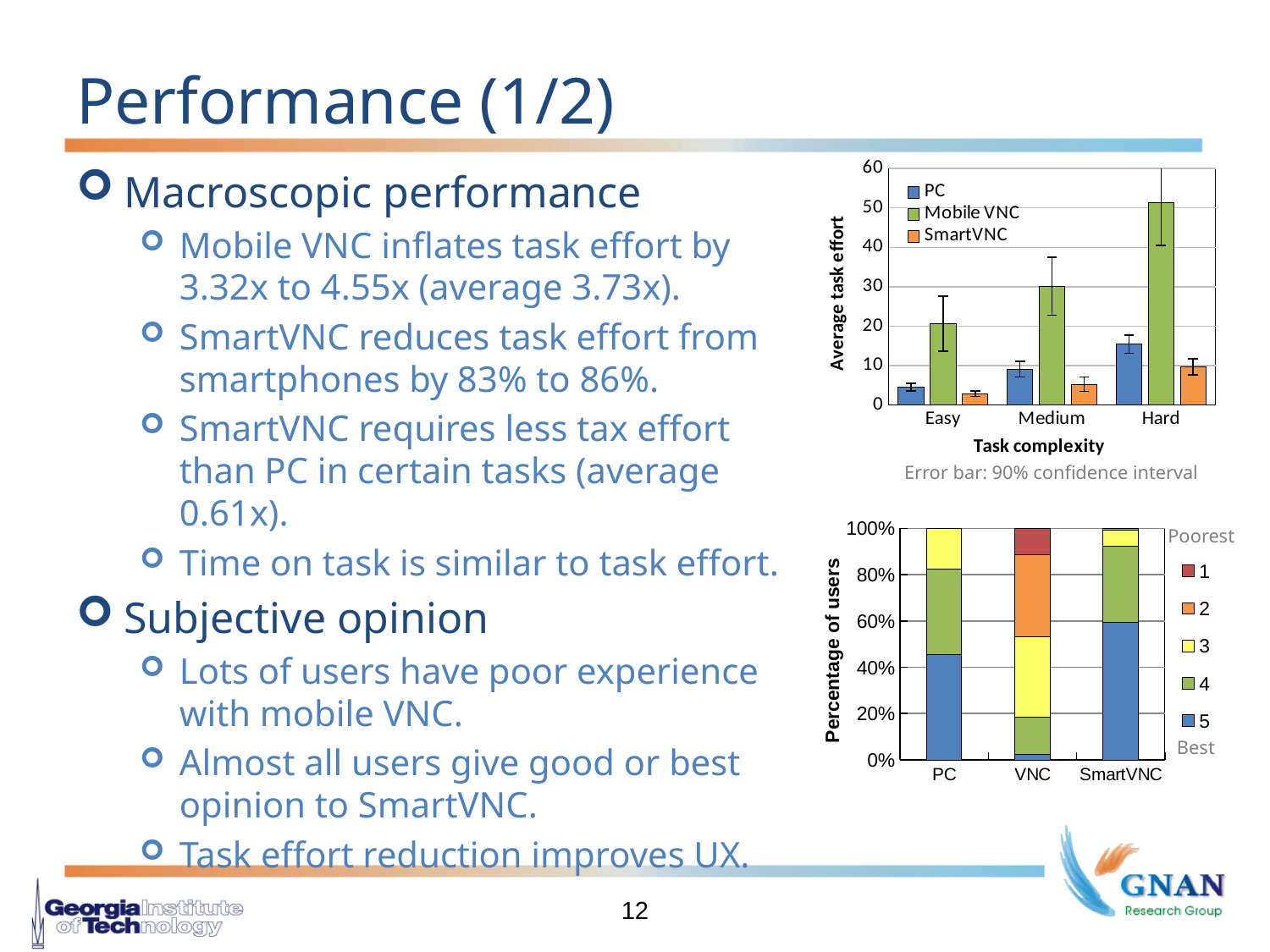
In the top chart, is the PC value for Easy tasks greater or less than 10? less How many series does the legend of the top chart list? 3 How many task complexity categories are shown on the x axis of the top chart? 3 What does the note below the top chart say the error bars represent? 90% confidence interval How many rating levels does the legend of the bottom chart list? 5 In the top chart, which series has the highest average task effort for Hard tasks? Mobile VNC What kind of chart is the bottom chart on the slide? stacked bar chart What kind of chart is the top chart on the slide? bar chart In the top chart, which is larger for Medium tasks: the PC value or the SmartVNC value? PC In the top chart, does the Mobile VNC average task effort rise or fall from Easy to Hard? rise In the top chart, is the Mobile VNC value for Hard tasks greater or less than 40? greater In the bottom chart, which of PC or SmartVNC has the larger share of users giving rating 5? SmartVNC